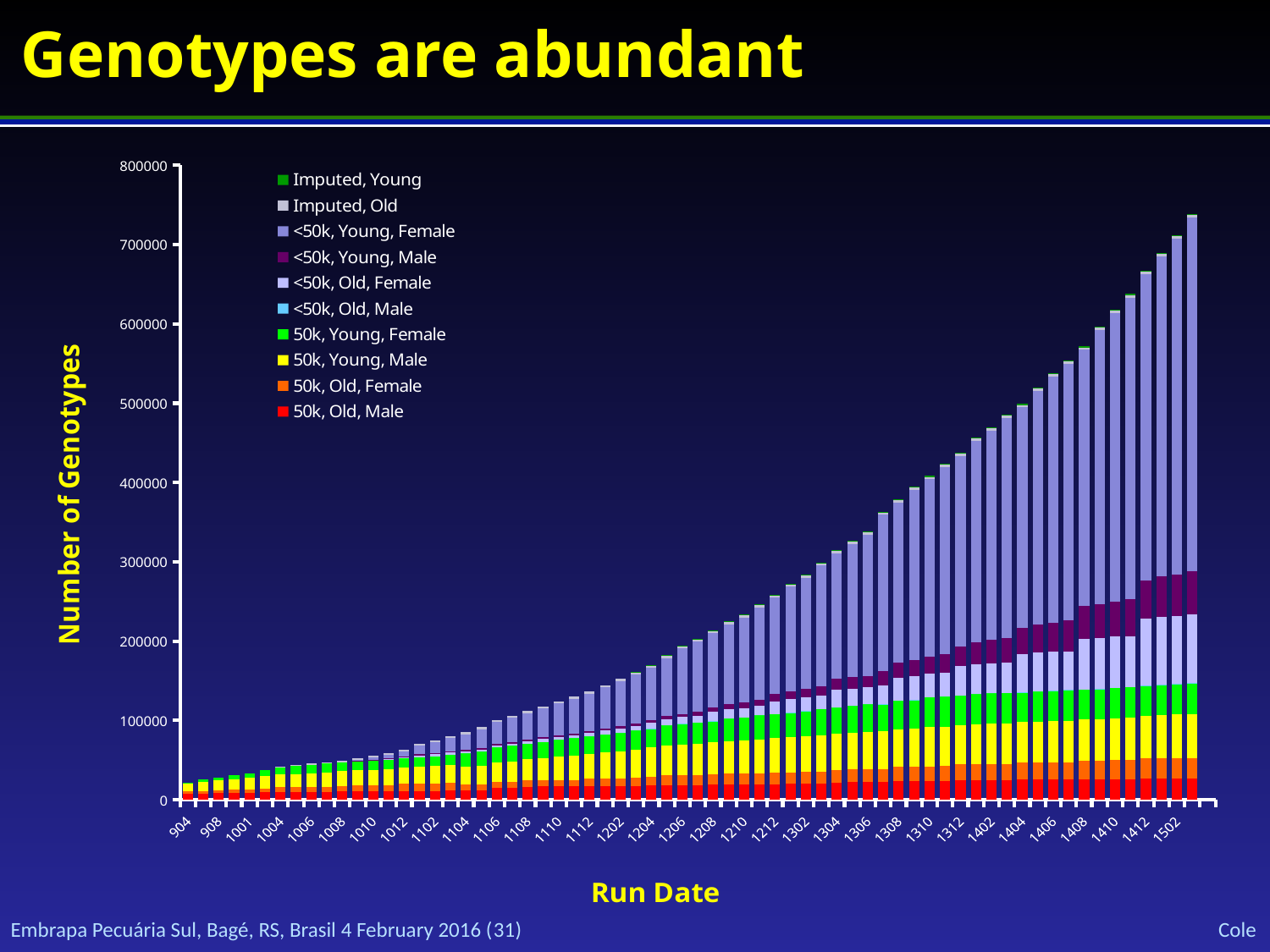
Is the total number of genotypes for run date 904 greater or less than 100000? less Which run date has the lowest total number of genotypes? 904 Is the total number of genotypes for run date 1306 greater or less than 300000? greater What kind of chart is shown on the slide? Stacked bar chart Which colour represents the series "50k, Old, Male" in the legend? Red Is the total number of genotypes for run date 1308 greater or less than 400000? less How many series does the legend list? 10 Do the total number of genotypes rise or fall as the run date increases along the x axis? Rise What is the title of the chart's y axis? Number of Genotypes Which run date has a larger total number of genotypes, 1502 or 904? 1502